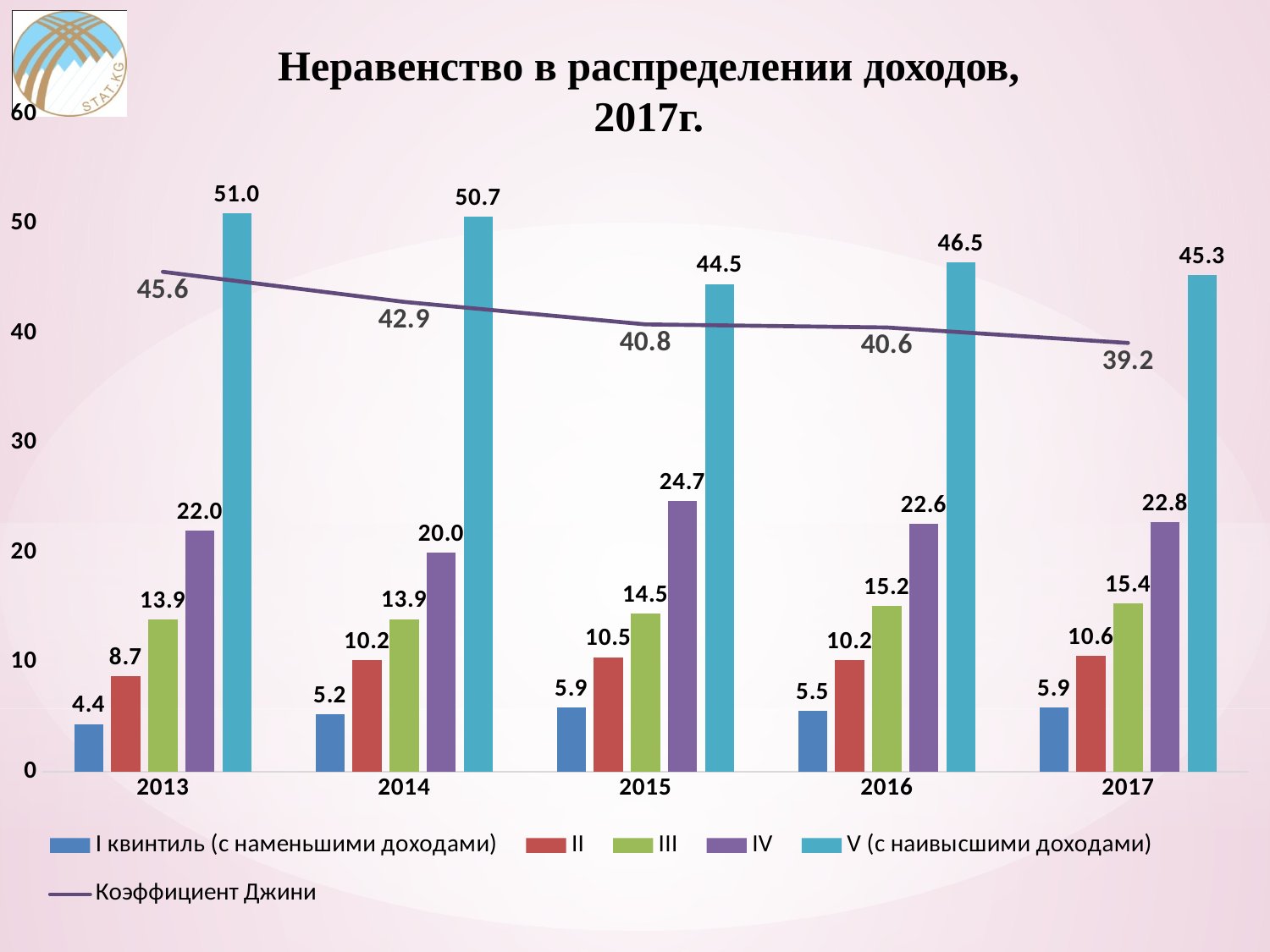
By how much did the Коэффициент Джини fall from 2013 to 2017? 6.4 Which is larger: the quintile IV value in 2015 or in 2016? 2015 What is the value for quintile III in 2016? 15.2 In which year is the V quintile (с наивысшими доходами) bar the highest? 2013 How many years are shown on the x axis? 5 What kind of chart is shown on the slide? combined bar and line chart How many series does the legend list? 6 Does the Коэффициент Джини line rise or fall from 2013 to 2017? fall In which year is the I квинтиль (с наменьшими доходами) bar the lowest? 2013 What is the difference between the V quintile and the I quintile values in 2017? 39.4 What is the value of the Коэффициент Джини line in 2017? 39.2 What is the value for the V quintile (с наивысшими доходами) in 2013? 51.0